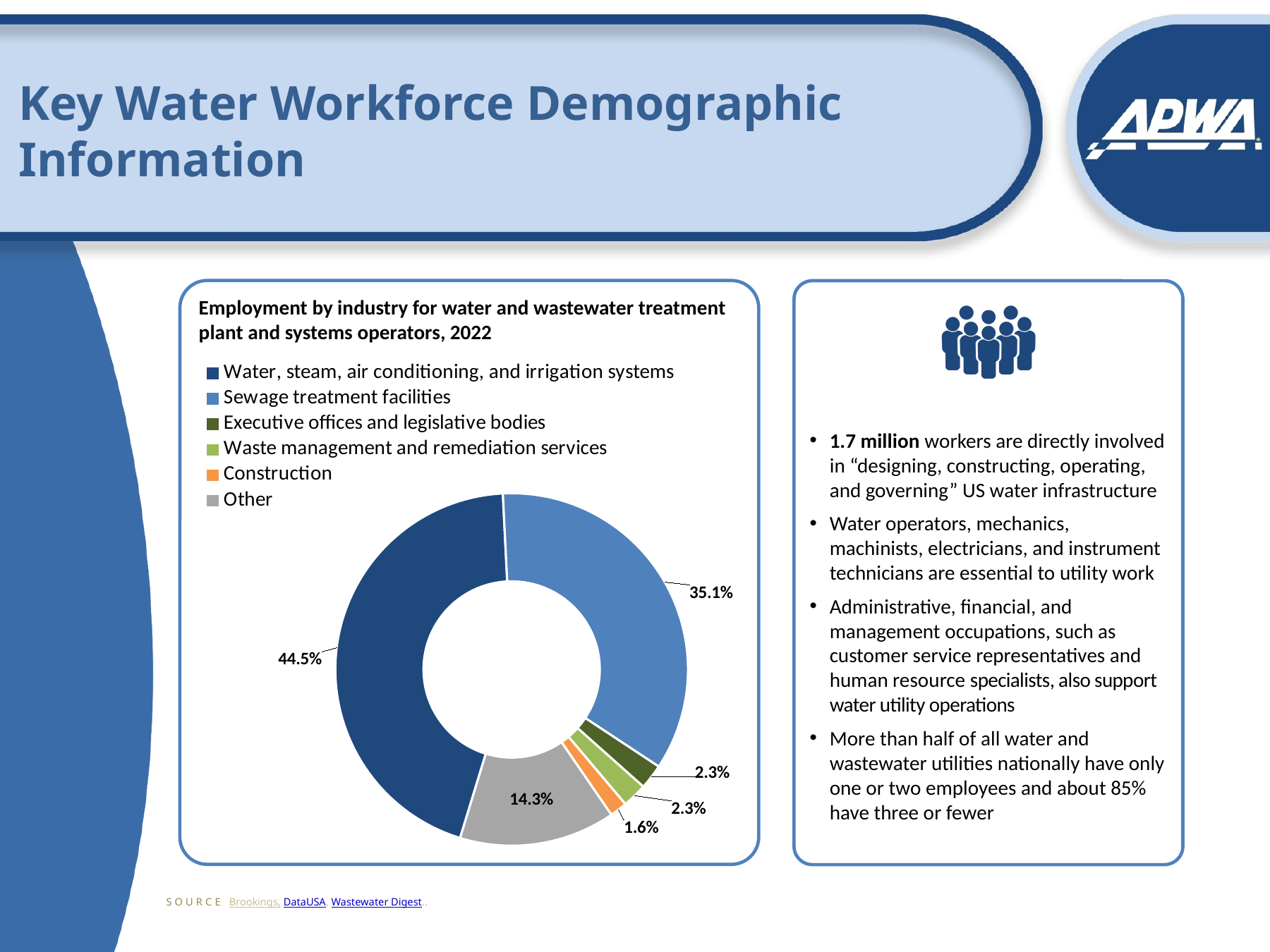
What share of employment is in construction? 1.6% What share of employment is in waste management and remediation services? 2.3% Which industry has the smallest share of employment? Construction What share of employment is in the Other category? 14.3% What share of employment is in sewage treatment facilities? 35.1% Which is larger: the share for Other or the share for sewage treatment facilities? Sewage treatment facilities What kind of chart is shown on the slide? Pie chart (donut) What is the title of the chart? Employment by industry for water and wastewater treatment plant and systems operators, 2022 How many industry categories does the legend list? 6 What is the difference in share between water, steam, air conditioning, and irrigation systems and sewage treatment facilities? 9.4% Which industry has the largest share of employment? Water, steam, air conditioning, and irrigation systems What share of employment is in water, steam, air conditioning, and irrigation systems? 44.5%